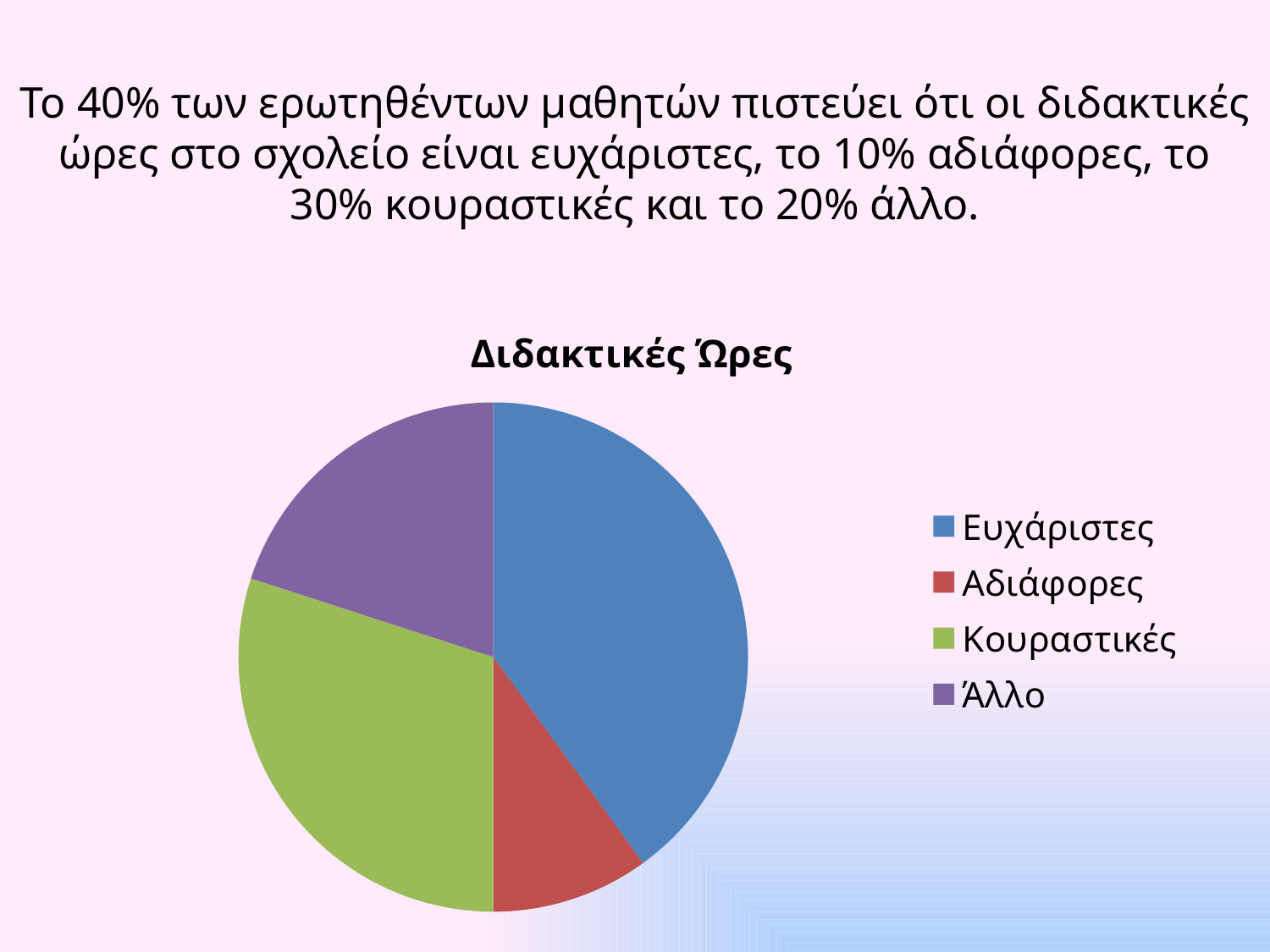
What is the difference in percentage points between the Ευχάριστες slice and the Άλλο slice? 20 What kind of chart is shown on the slide? pie chart Which category has the smallest slice in the pie chart? Αδιάφορες What share of the pie does Κουραστικές represent? 30% What is the title of the pie chart? Διδακτικές Ώρες Which category has the largest slice in the pie chart? Ευχάριστες What share of the pie does Αδιάφορες represent? 10% What share of the pie does Ευχάριστες represent? 40% How many slices does the pie chart have? 4 Which slice is larger, Κουραστικές or Άλλο? Κουραστικές What colour is the Κουραστικές slice in the pie chart? green How many entries does the legend of the pie chart list? 4